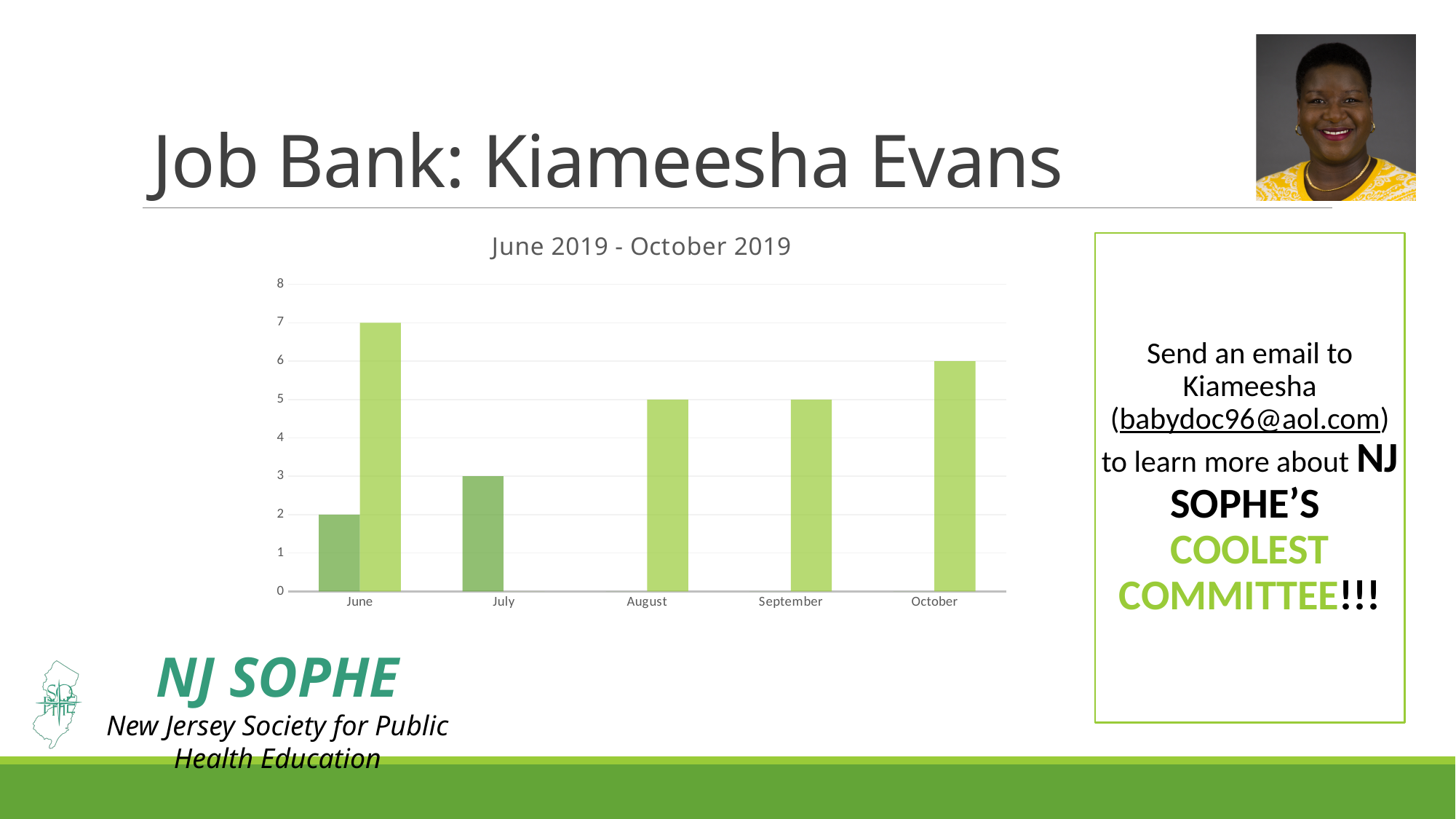
What is the value of the bar for August? 5 What is the value of the bar for October? 6 Which month has the tallest bar in the chart? June What is the difference between the light green bar for June and the bar for October? 1 What is the value of the light green bar for June? 7 How many months are shown on the x axis of the chart? 5 Is the bar for October larger or smaller than the bar for September? larger What is the value of the dark green bar for June? 2 What kind of chart is shown on the slide? bar chart What is the value of the bar for July? 3 What is the title of the chart? June 2019 - October 2019